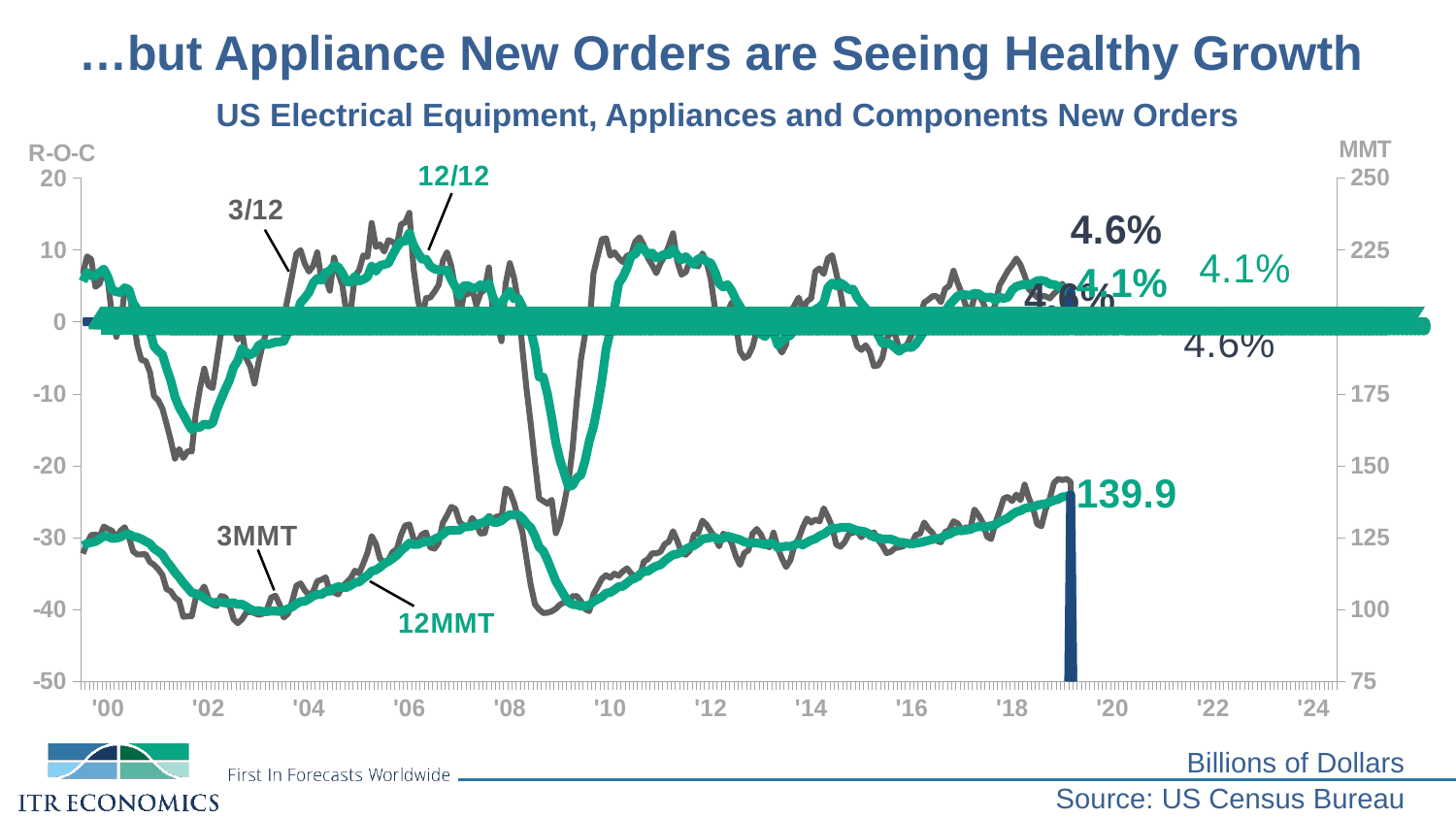
What is the latest 3/12 rate-of-change labeled on the chart? 4.6% What is the latest 12MMT value labeled on the chart? 139.9 What is the source cited for the chart data? US Census Bureau Is the 12/12 rate-of-change at its 2009 low greater or less than -10? less What is the latest 12/12 rate-of-change labeled on the chart? 4.1% What is the title of the chart? US Electrical Equipment, Appliances and Components New Orders How many data series are labeled on the chart? 4 What is the difference between the latest 3/12 rate (4.6%) and the latest 12/12 rate (4.1%)? 0.5 percentage points Is the 12MMT value at its 2009 low greater or less than 125 on the MMT axis? less Which is larger at the latest data point, the 3/12 rate-of-change or the 12/12 rate-of-change? 3/12 Does the 12MMT line rise or fall from 2016 to 2019? Rise What kind of chart is shown on the slide? Line chart